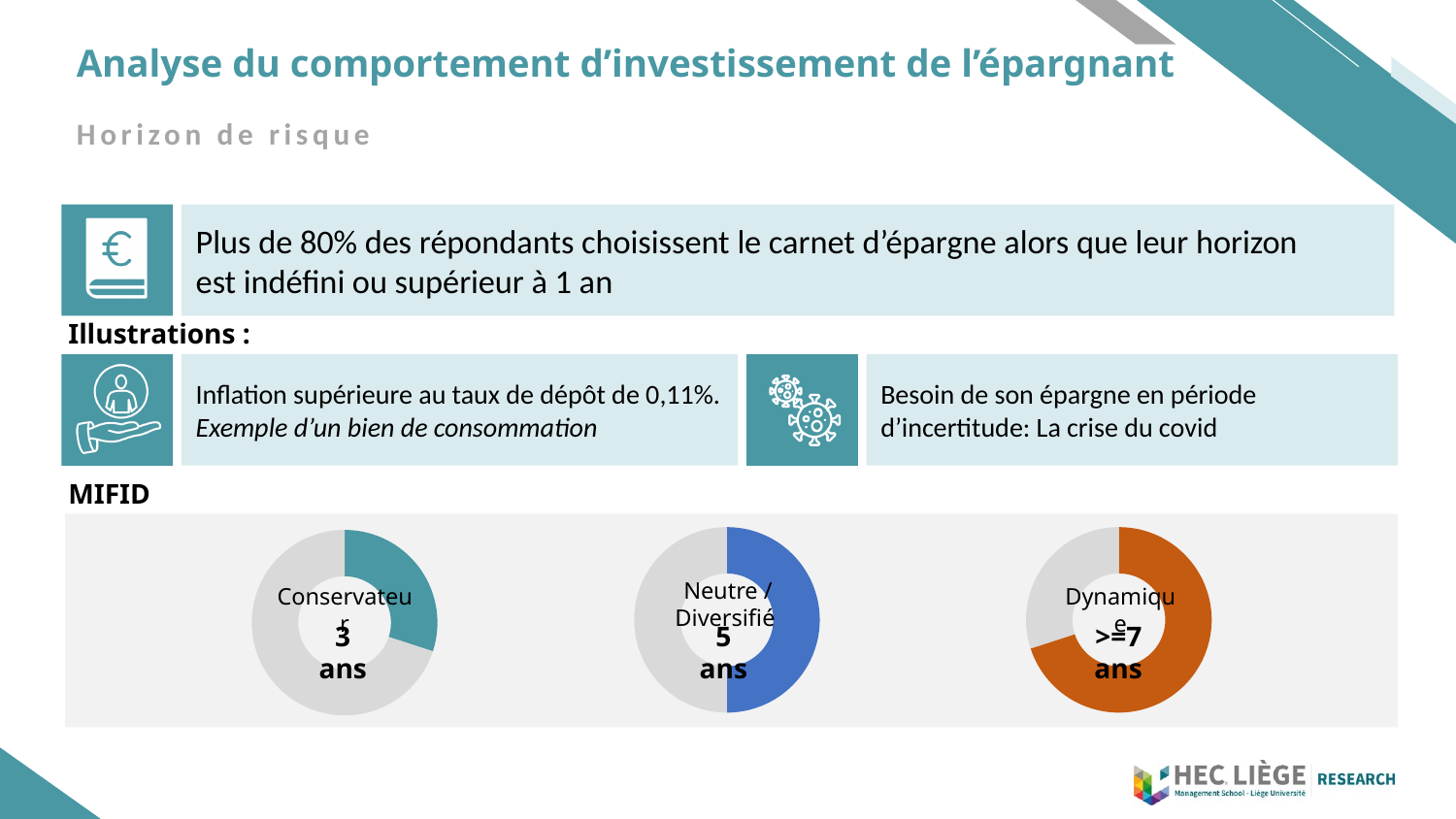
Which of the three MIFID donut charts has the smallest coloured (filled) portion? Conservateur Which of the three MIFID donut charts has the largest coloured (filled) portion? Dynamique What horizon is printed in the centre of the Dynamique donut chart? >=7 ans How many donut charts are shown in the MIFID section? 3 Is the coloured portion of the Dynamique donut larger or smaller than that of the Conservateur donut? Larger What colour is the filled portion of the Dynamique donut chart? Orange What horizon is printed in the centre of the Conservateur donut chart? 3 ans Which profile label is shown on the leftmost donut chart? Conservateur What colour is the filled portion of the Neutre / Diversifié donut chart? Blue What kind of charts are shown in the MIFID section of the slide? Donut charts Is the coloured portion of the Neutre / Diversifié donut larger or smaller than that of the Conservateur donut? Larger What horizon is printed in the centre of the Neutre / Diversifié donut chart? 5 ans